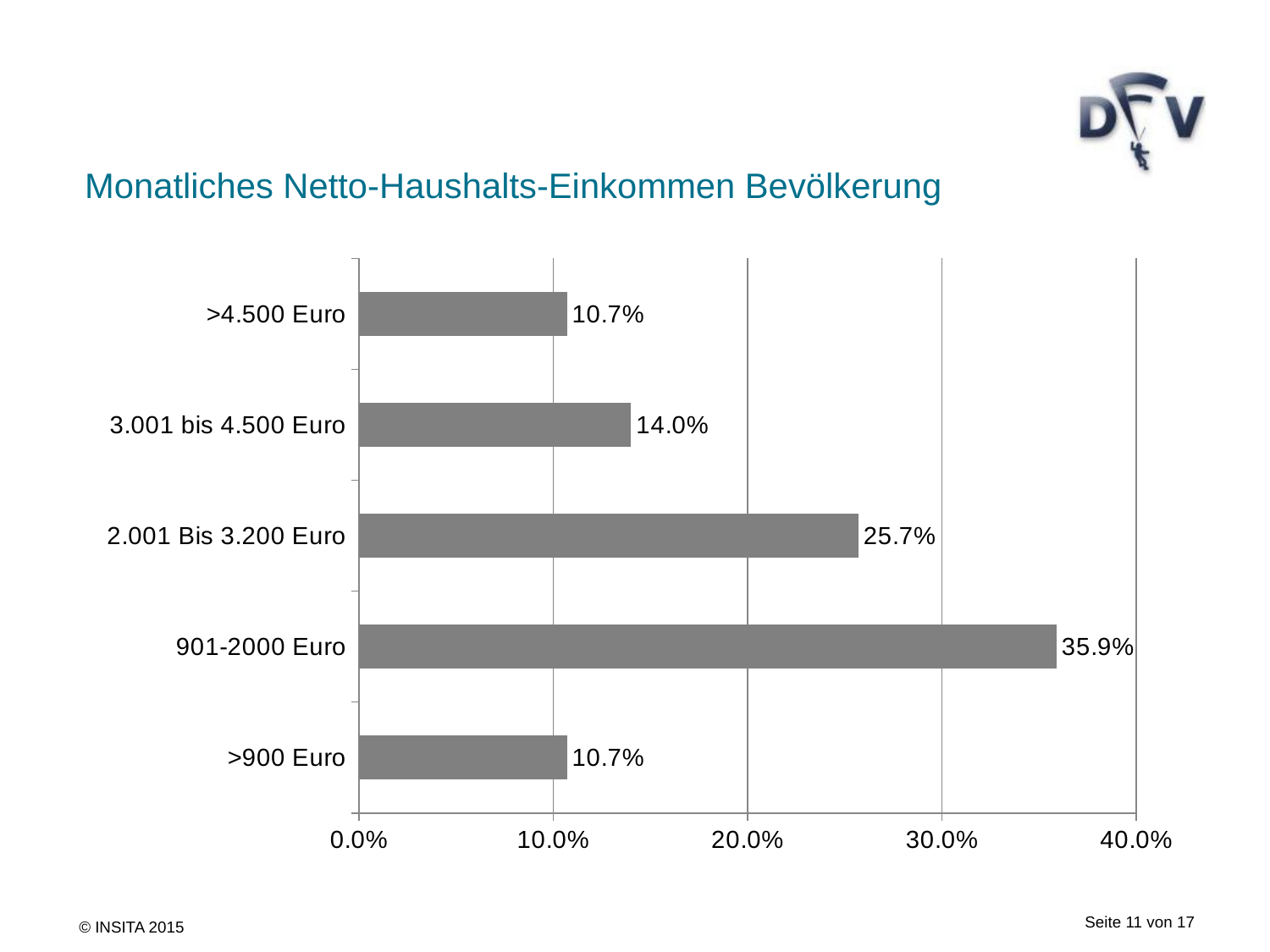
Which is larger, the value for 2.001 Bis 3.200 Euro or the value for 3.001 bis 4.500 Euro? 2.001 Bis 3.200 Euro What is the value for 2.001 Bis 3.200 Euro? 25.7% What is the difference between the values for 3.001 bis 4.500 Euro and >4.500 Euro? 3.3% How many income categories are shown in the chart? 5 What is the title of the chart? Monatliches Netto-Haushalts-Einkommen Bevölkerung Is the value for 901-2000 Euro greater or less than 30.0%? greater What is the difference between the values for 901-2000 Euro and 2.001 Bis 3.200 Euro? 10.2% Which income category has the highest value? 901-2000 Euro What is the value for >4.500 Euro? 10.7% What kind of chart is shown on the slide? Bar chart What is the value for 3.001 bis 4.500 Euro? 14.0% What is the value for 901-2000 Euro? 35.9%